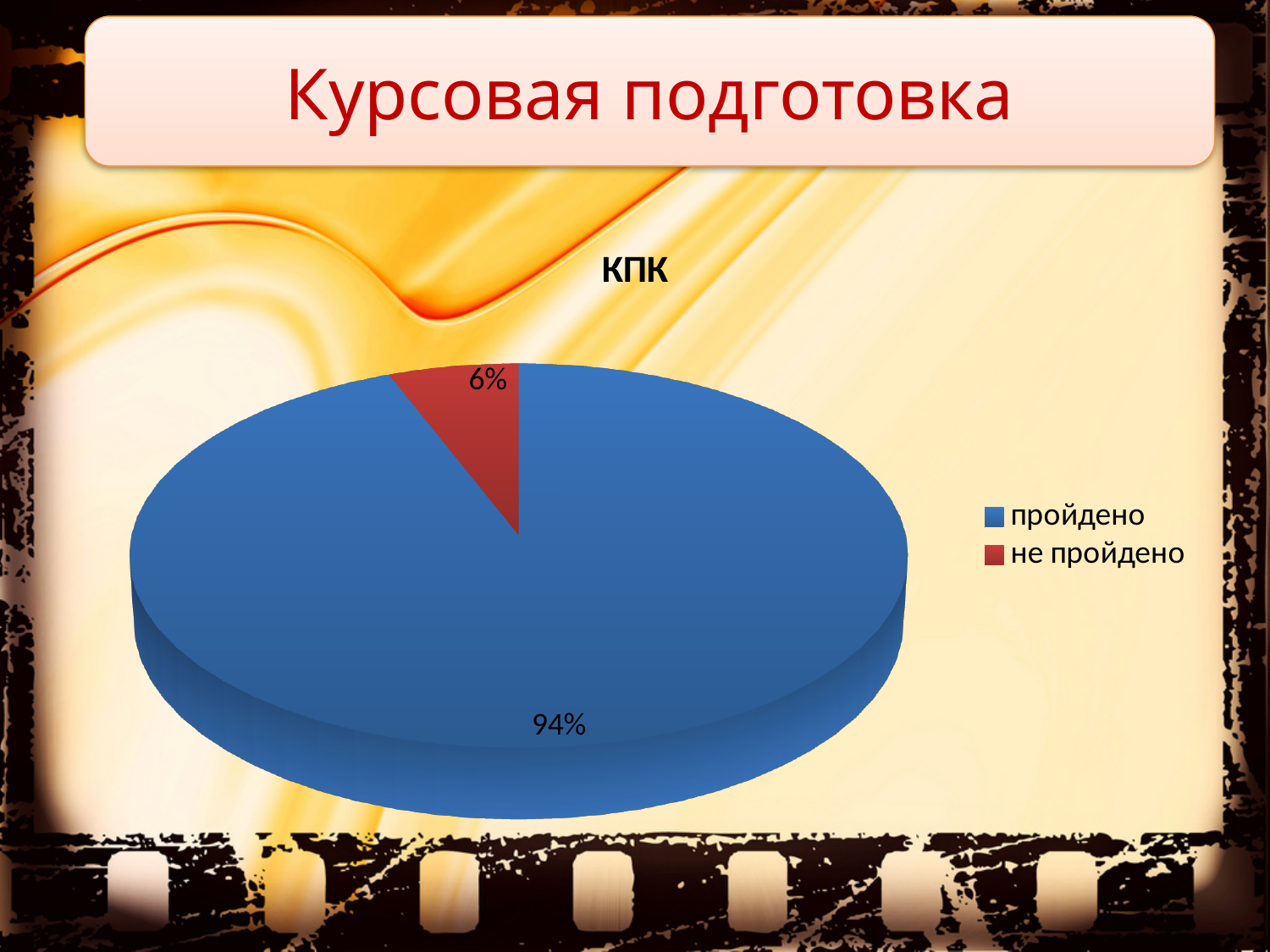
What is the difference in percentage points between "пройдено" and "не пройдено"? 88 Which category has the smallest share of the pie? не пройдено What type of chart is shown on the slide? pie chart What is the title of the chart? КПК What colour is the slice for "не пройдено"? red Which is larger, the share for "пройдено" or for "не пройдено"? пройдено How many entries does the legend list? 2 Which category has the largest share of the pie? пройдено What percentage is shown for "пройдено"? 94% What percentage is shown for "не пройдено"? 6% How many slices does the pie chart have? 2